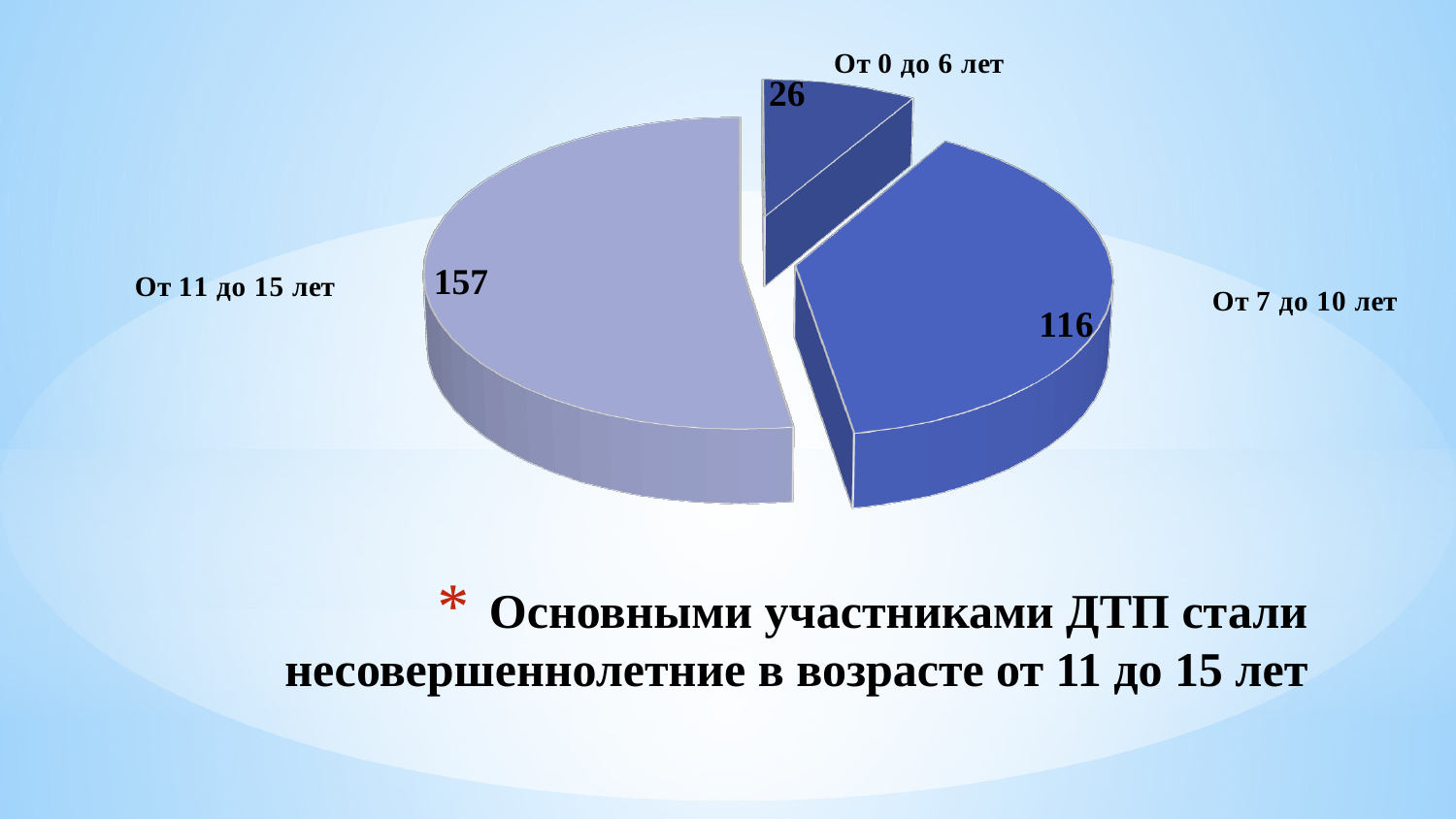
What is the value for the slice "От 0 до 6 лет"? 26 What is the difference between the values for "От 7 до 10 лет" and "От 0 до 6 лет"? 90 Which is larger, the value for "От 7 до 10 лет" or the value for "От 0 до 6 лет"? От 7 до 10 лет Which age group has the largest slice of the pie? От 11 до 15 лет What is the total of all three slices in the pie chart? 299 Which slice of the pie chart is drawn in the lightest colour? От 11 до 15 лет Which age group has the smallest slice of the pie? От 0 до 6 лет What is the value for the slice "От 11 до 15 лет"? 157 What kind of chart is shown on the slide? pie chart How many slices does the pie chart have? 3 What is the value for the slice "От 7 до 10 лет"? 116 What is the difference between the values for "От 11 до 15 лет" and "От 7 до 10 лет"? 41